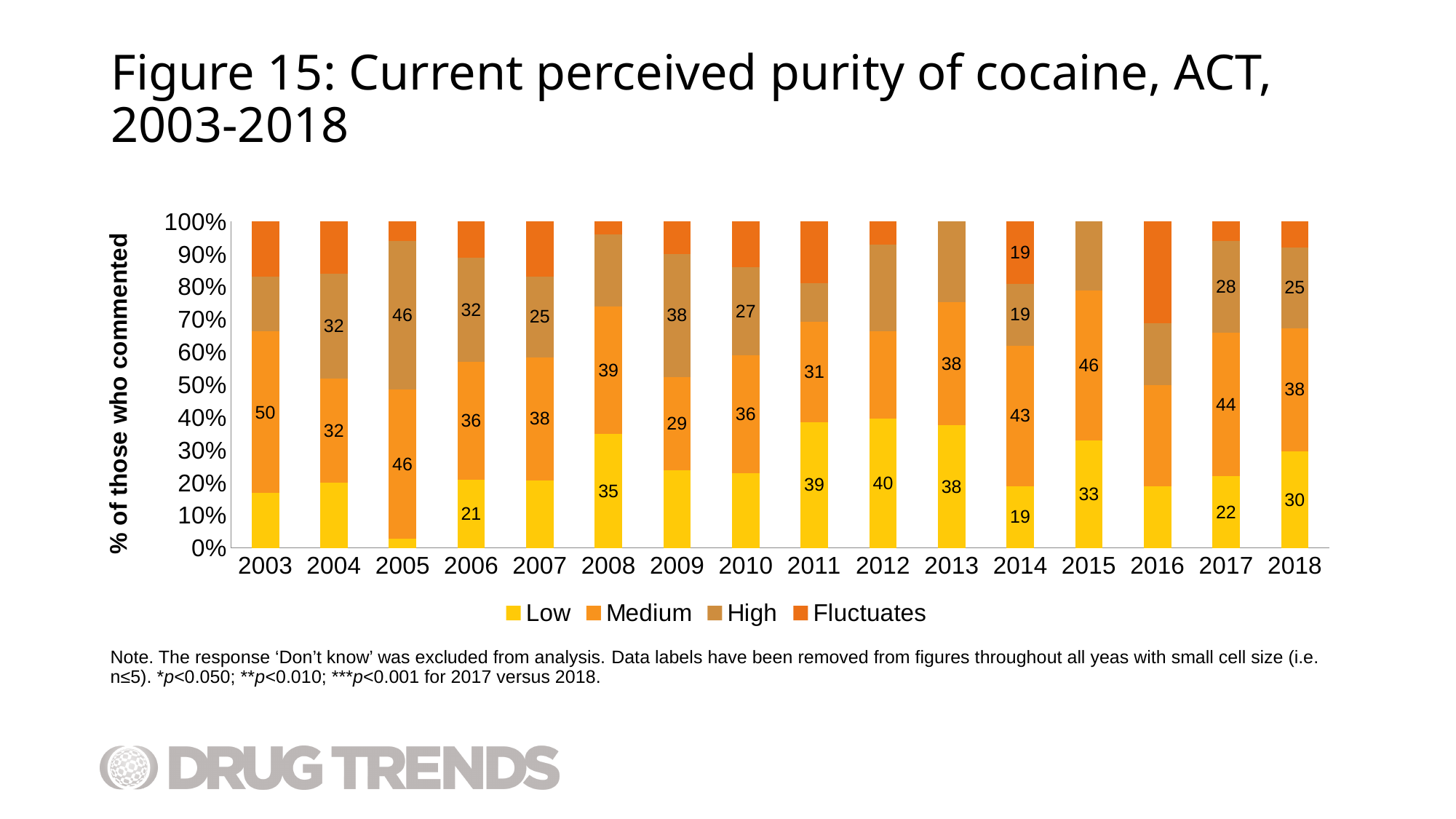
What is the labelled value for Medium in 2003? 50 How many series does the legend list? 4 What is the labelled value for Low in 2012? 40 What are the four legend entries in the chart? Low, Medium, High, Fluctuates What is the labelled value for High in 2017? 28 By how much does the Low value in 2018 exceed the Low value in 2017? 8 What is the labelled value for Medium in 2014? 43 Is the Low value for 2016 greater or less than 30%? less What is the labelled value for Fluctuates in 2014? 19 How many years are shown along the x axis of the chart? 16 Which year has the larger Medium value, 2015 or 2018? 2015 What kind of chart is shown on the slide? Stacked bar chart